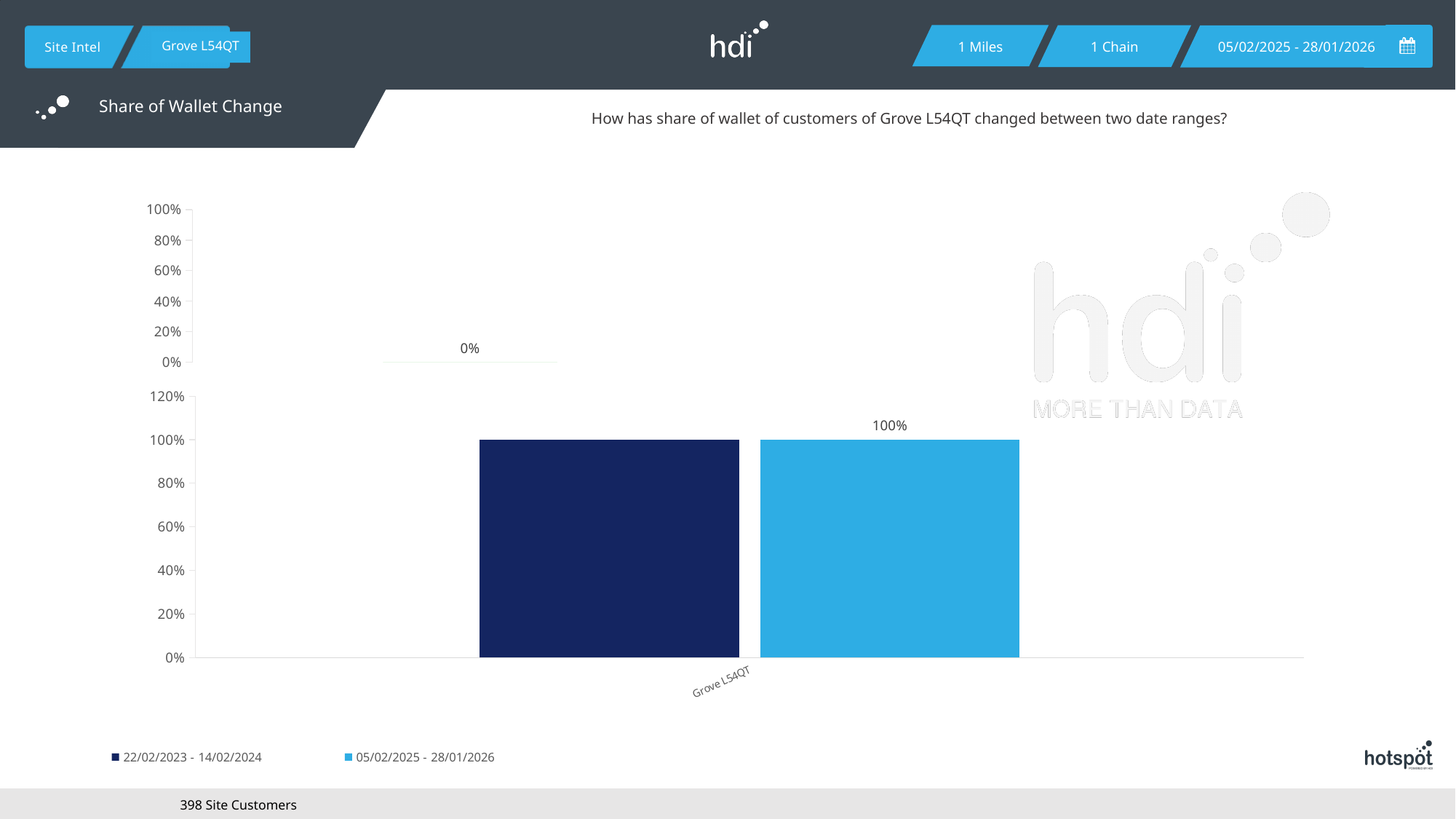
How many series does the legend at the bottom of the slide list? 2 On the bottom chart, what is the share of wallet value for Grove L54QT in the 22/02/2023 - 14/02/2024 period? 100% What is the highest tick value shown on the y axis of the bottom chart? 120% What is the category label on the x axis of the bottom chart? Grove L54QT Which legend entry is shown in dark navy on the bottom chart? 22/02/2023 - 14/02/2024 What kind of chart is the bottom chart? bar chart On the top chart, what value is printed above the bar for the share of wallet change? 0% On the bottom chart, is the value for Grove L54QT in the 22/02/2023 - 14/02/2024 period greater or less than 120%? less How many categories are shown on the x axis of the bottom chart? 1 On the bottom chart, what is the share of wallet value for Grove L54QT in the 05/02/2025 - 28/01/2026 period? 100% On the bottom chart, what is the difference between the 22/02/2023 - 14/02/2024 value and the 05/02/2025 - 28/01/2026 value for Grove L54QT? 0% On the bottom chart, is the value for Grove L54QT in the 05/02/2025 - 28/01/2026 period greater or less than 80%? greater